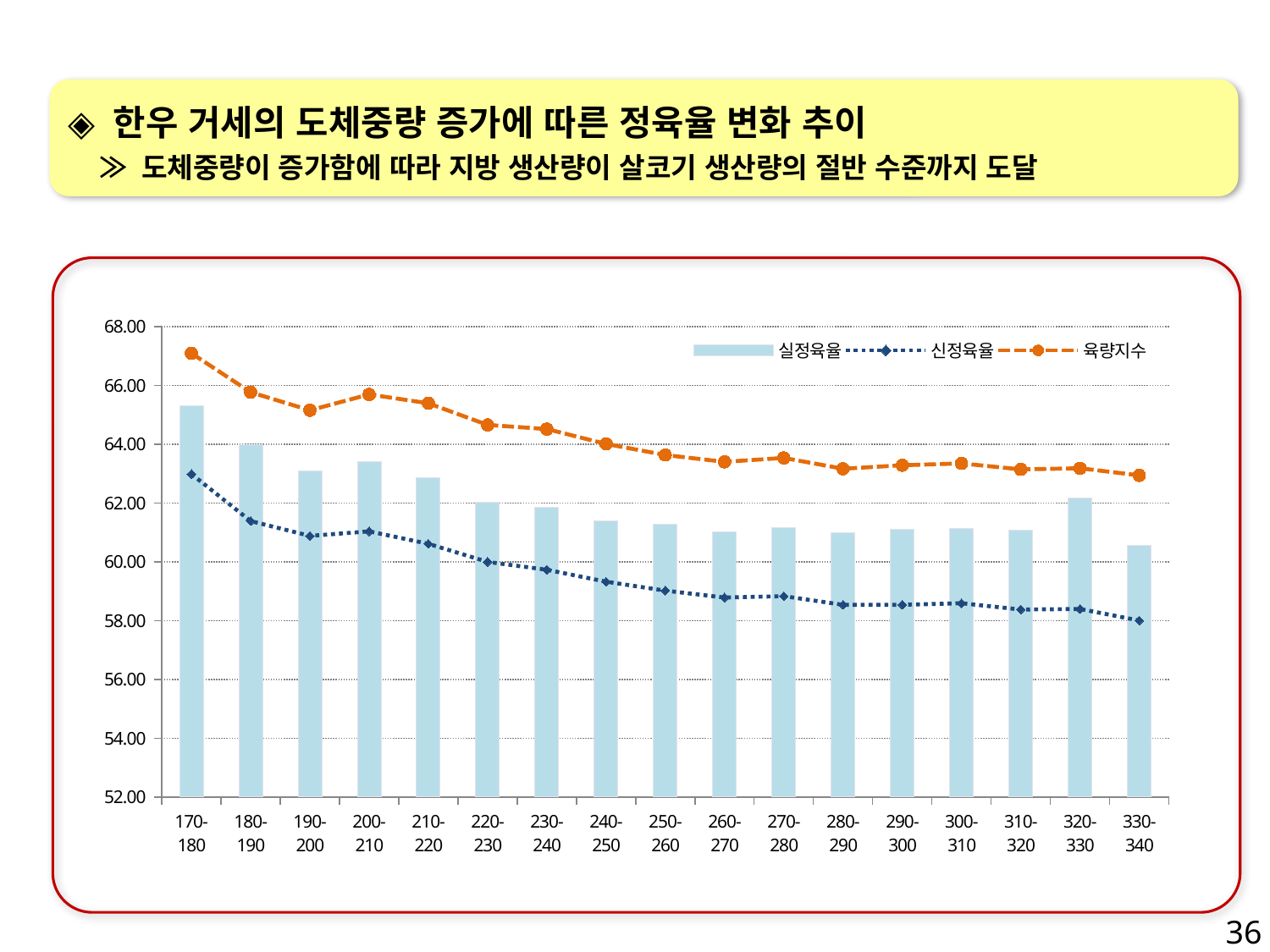
Do the 신정육율 values generally rise or fall as carcass weight increases along the x axis? fall What kind of chart is shown on the slide? A combined bar and line chart Is the 신정육율 value for 330-340 greater or less than 60.00? less Which category has the lowest 신정육율 value? 330-340 Which category has the highest 육량지수 value? 170-180 Is the 실정육율 value for 170-180 greater or less than 64.00? greater Which category has the highest 실정육율 bar? 170-180 How many series does the legend list? 3 Is the 육량지수 value for 170-180 greater or less than 66.00? greater Which is larger, the 실정육율 bar for 320-330 or for 310-320? 320-330 Which category has the lowest 실정육율 bar? 330-340 How many carcass weight categories are shown on the x axis? 17